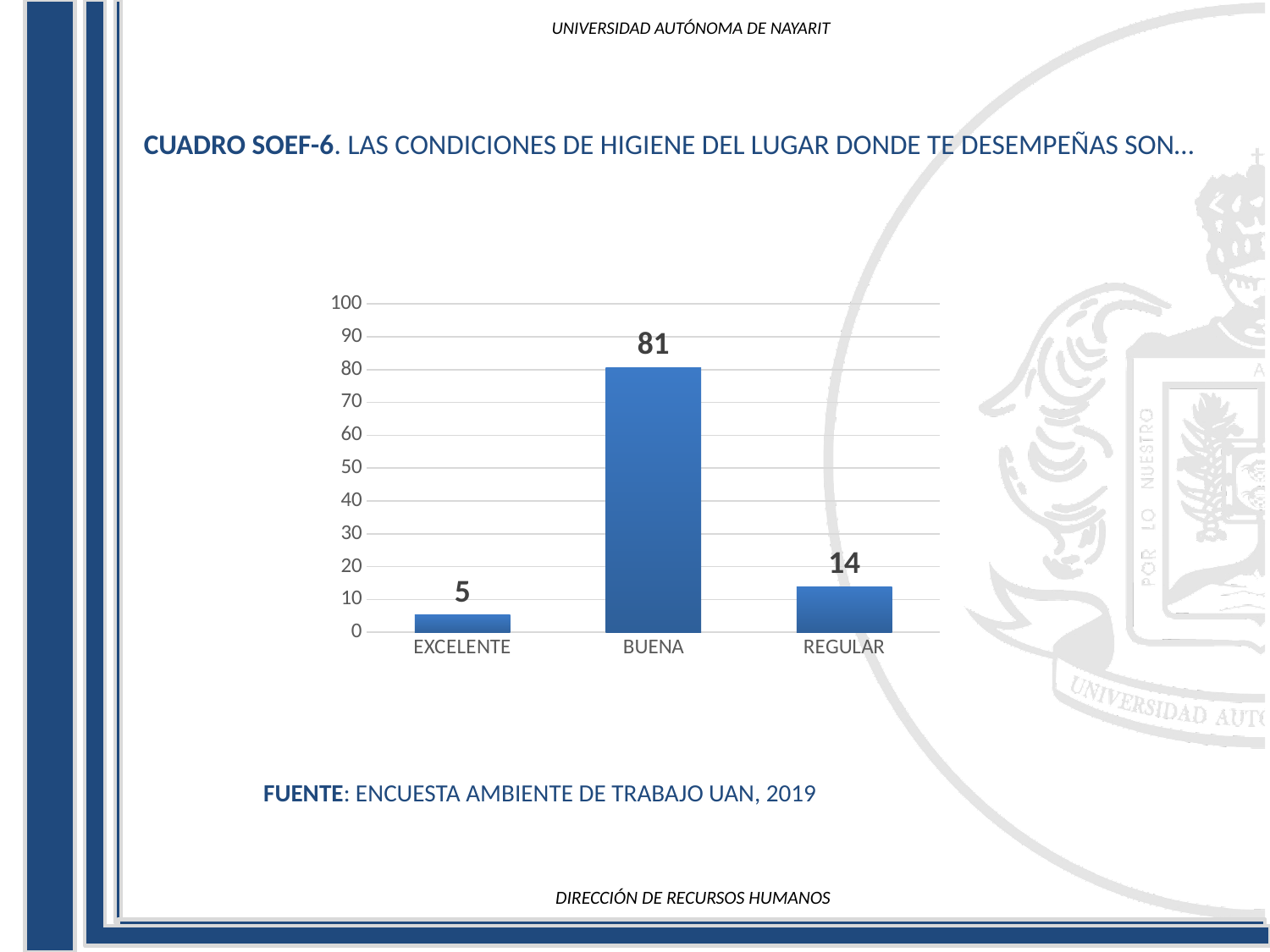
What is the value for EXCELENTE? 5 Which is larger, the value for REGULAR or the value for EXCELENTE? REGULAR Is the value for BUENA greater or less than 50? greater Which category has the highest value? BUENA What is the source cited below the chart? ENCUESTA AMBIENTE DE TRABAJO UAN, 2019 What is the value for REGULAR? 14 What is the difference between the values for REGULAR and EXCELENTE? 9 What is the difference between the values for BUENA and REGULAR? 67 What kind of chart is shown on the slide? bar chart How many categories are shown on the x axis? 3 Which category has the lowest value? EXCELENTE What is the value for BUENA? 81